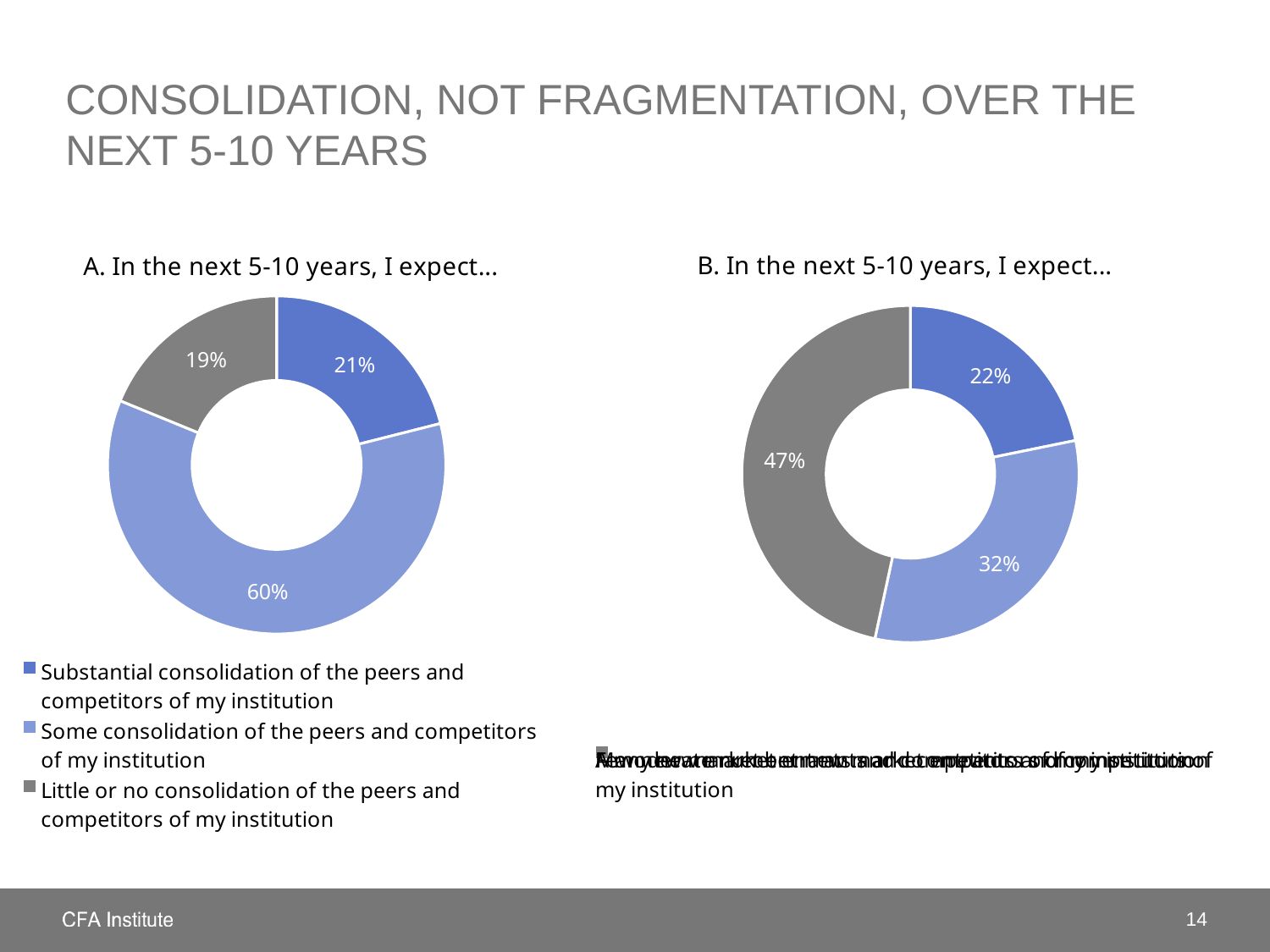
On chart A, what share of respondents expect little or no consolidation of the peers and competitors of my institution? 19% On chart A, what share of respondents expect substantial consolidation of the peers and competitors of my institution? 21% On chart B, what is the smallest percentage shown? 22% On chart A ("In the next 5-10 years, I expect..."), what share of respondents expect some consolidation of the peers and competitors of my institution? 60% On chart A, which response has the largest share? Some consolidation of the peers and competitors of my institution On chart B, what percentage is shown for the light blue segment? 32% How many segments does chart B have? 3 On chart A, which is larger: the share for substantial consolidation or the share for little or no consolidation? Substantial consolidation On chart A, which response has the smallest share? Little or no consolidation of the peers and competitors of my institution On chart A, what is the difference in percentage points between the share for some consolidation and the share for substantial consolidation? 39 What type of chart is chart A? Donut (pie) chart On chart B ("In the next 5-10 years, I expect..."), what is the largest percentage shown? 47%